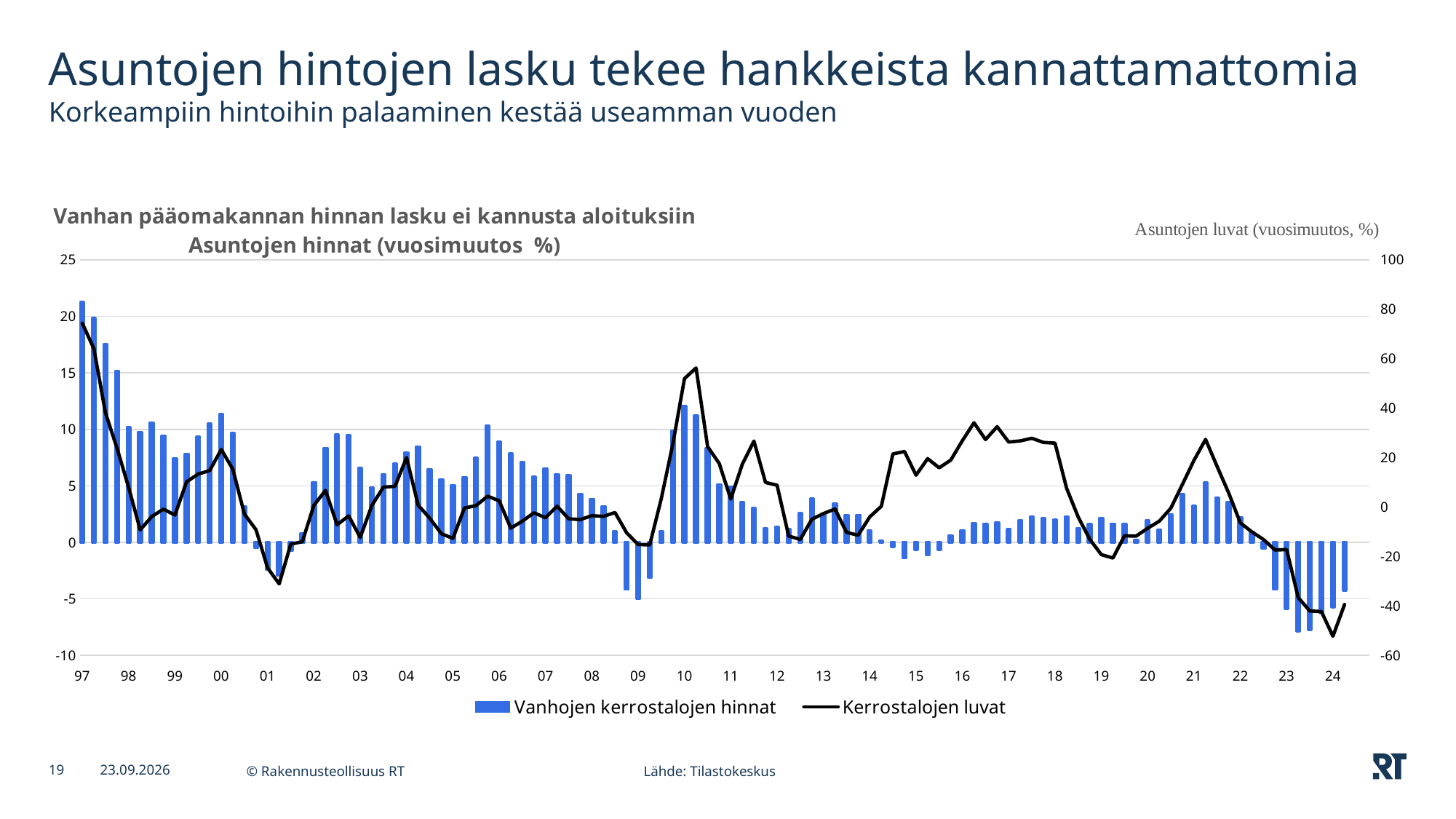
What label is printed above the right-hand axis of the chart? Asuntojen luvat (vuosimuutos, %) How many series does the chart legend list? 2 How many year labels are shown on the x axis? 28 What kind of chart is shown on the slide? bar and line chart Is the first Vanhojen kerrostalojen hinnat bar (at 97) greater or less than 20? greater In which year on the x axis does the Vanhojen kerrostalojen hinnat bar reach its lowest value? 23 In which year on the x axis does the Vanhojen kerrostalojen hinnat bar reach its highest value? 97 Is the highest point of the Kerrostalojen luvat line greater or less than 40 on the right-hand axis? greater Do the Vanhojen kerrostalojen hinnat bars rise or fall from 97 to 98? fall What is the title printed above the chart? Vanhan pääomakannan hinnan lasku ei kannusta aloituksiin Asuntojen hinnat (vuosimuutos %) Which is larger, the Vanhojen kerrostalojen hinnat bar at 97 or the bar at 10? 97 Is the lowest point of the Kerrostalojen luvat line greater or less than -40 on the right-hand axis? less